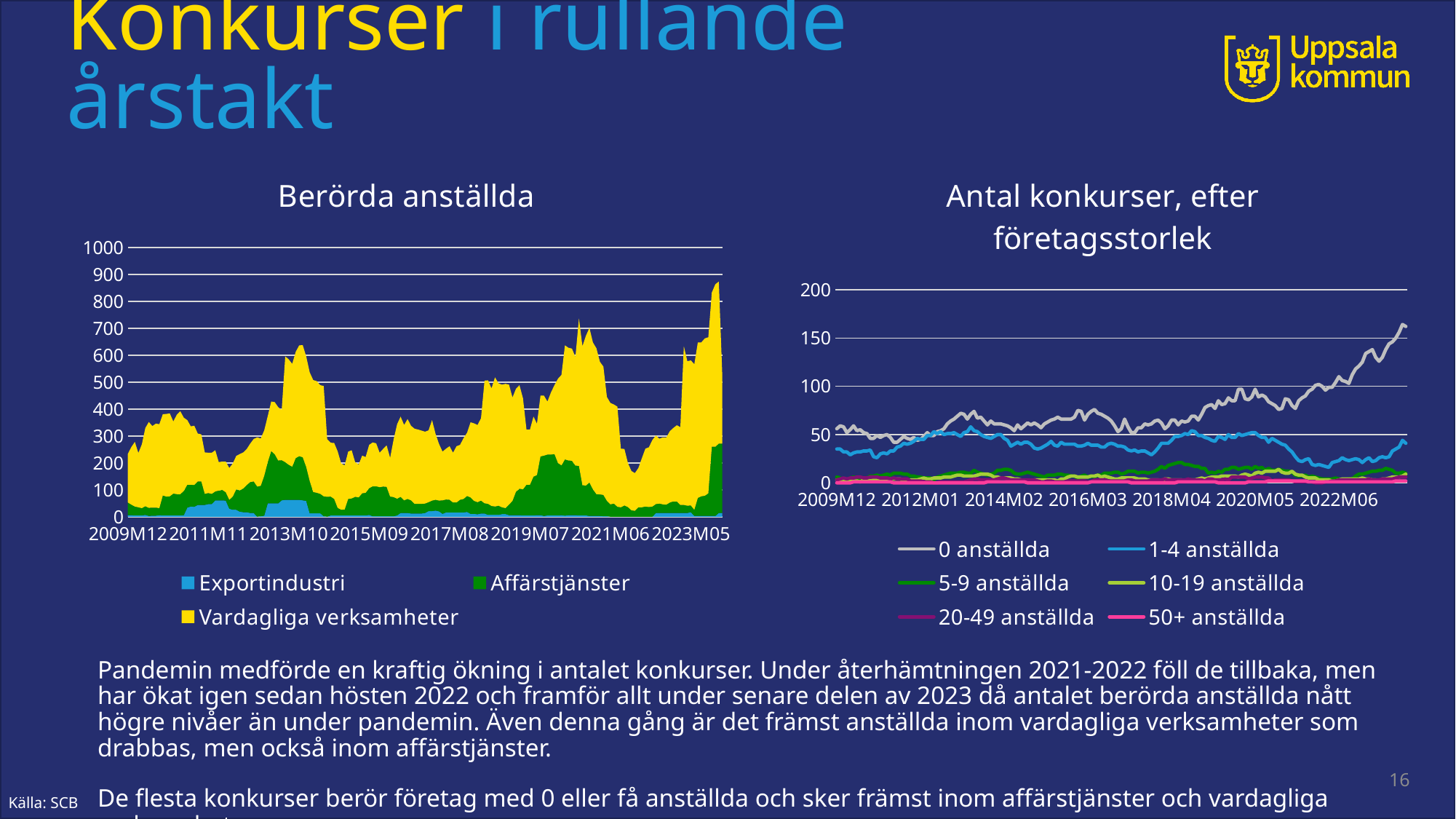
What kind of chart is the "Antal konkurser, efter företagsstorlek" chart on the right? Line chart What is the first x-axis label on the "Berörda anställda" chart? 2009M12 In the "Berörda anställda" chart, is the highest stacked total (reached near the end of the period) greater or less than 800? greater In the "Antal konkurser, efter företagsstorlek" chart, is the final value of the "0 anställda" series greater or less than 150? greater How many series does the legend of the "Antal konkurser, efter företagsstorlek" chart list? 6 In the "Antal konkurser, efter företagsstorlek" chart, which is larger at the end of the period: "0 anställda" or "1-4 anställda"? 0 anställda In the "Berörda anställda" chart, which series accounts for the largest share of the stacked total across the period? Vardagliga verksamheter In the "Antal konkurser, efter företagsstorlek" chart, does the "0 anställda" series overall rise or fall from 2018 to the end of the period? Rise What kind of chart is the "Berörda anställda" chart on the left? Stacked area chart In the "Antal konkurser, efter företagsstorlek" chart, which series has the highest value at the end of the period? 0 anställda How many series does the legend of the "Berörda anställda" chart list? 3 In the "Antal konkurser, efter företagsstorlek" chart, is the final value of the "1-4 anställda" series greater or less than 50? less